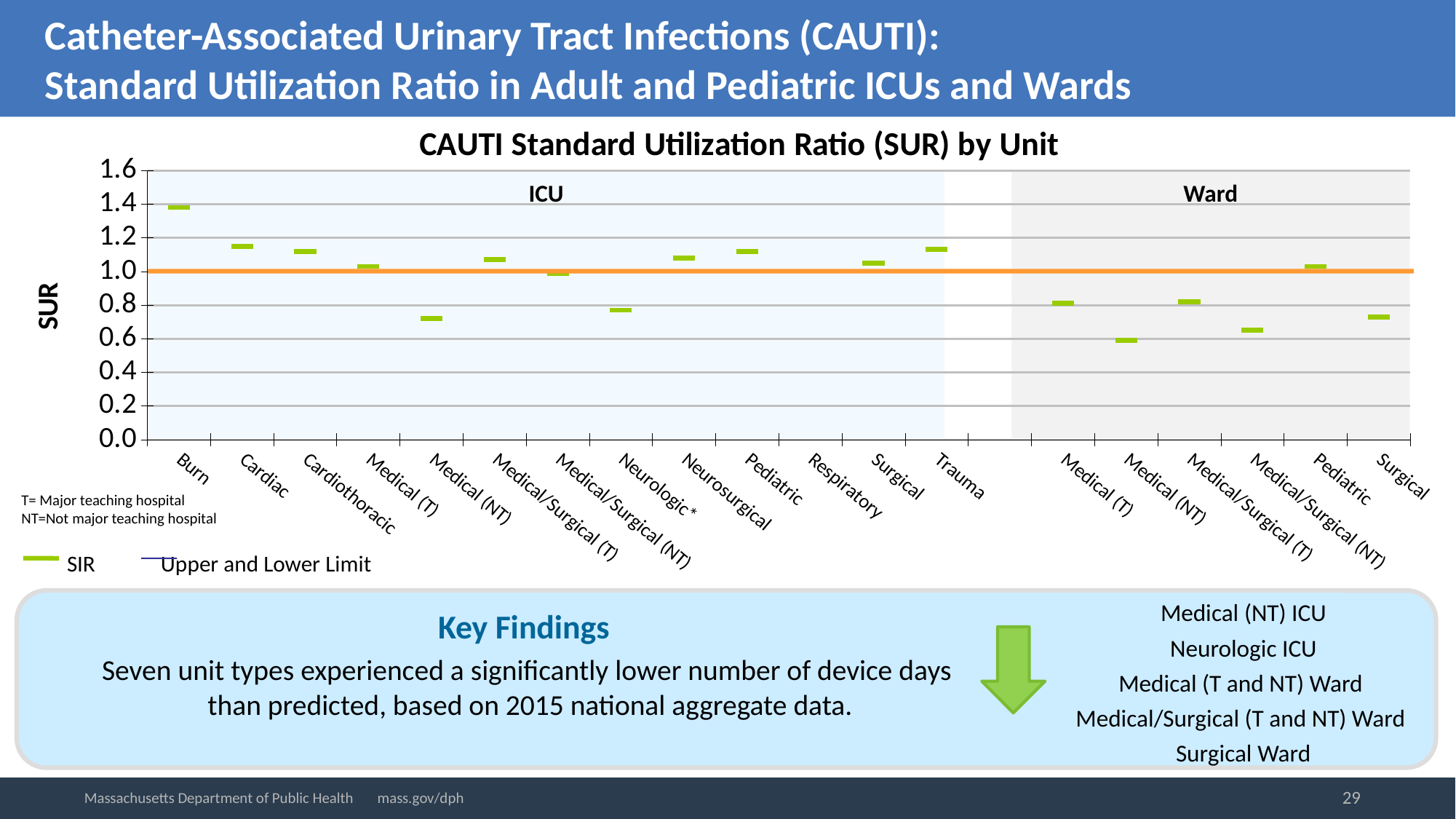
Which unit has the highest SUR on the chart? Burn (ICU) Is the SUR for the Burn ICU greater or less than 1.2? greater Which has the larger SUR, the Burn ICU or the Cardiac ICU? Burn ICU Which unit has the lowest SUR on the chart? Medical (NT) Ward Is the SUR for the Cardiac ICU greater or less than 1.0? greater How many unit categories are listed in the Ward section of the x axis? 6 How many entries does the chart legend list? 2 Is the SUR for the Medical/Surgical (NT) Ward greater or less than 0.8? less How many unit categories are listed in the ICU section of the x axis? 13 What is the title of the chart? CAUTI Standard Utilization Ratio (SUR) by Unit Which has the larger SUR, the Medical (T) ICU or the Medical (NT) ICU? Medical (T) ICU